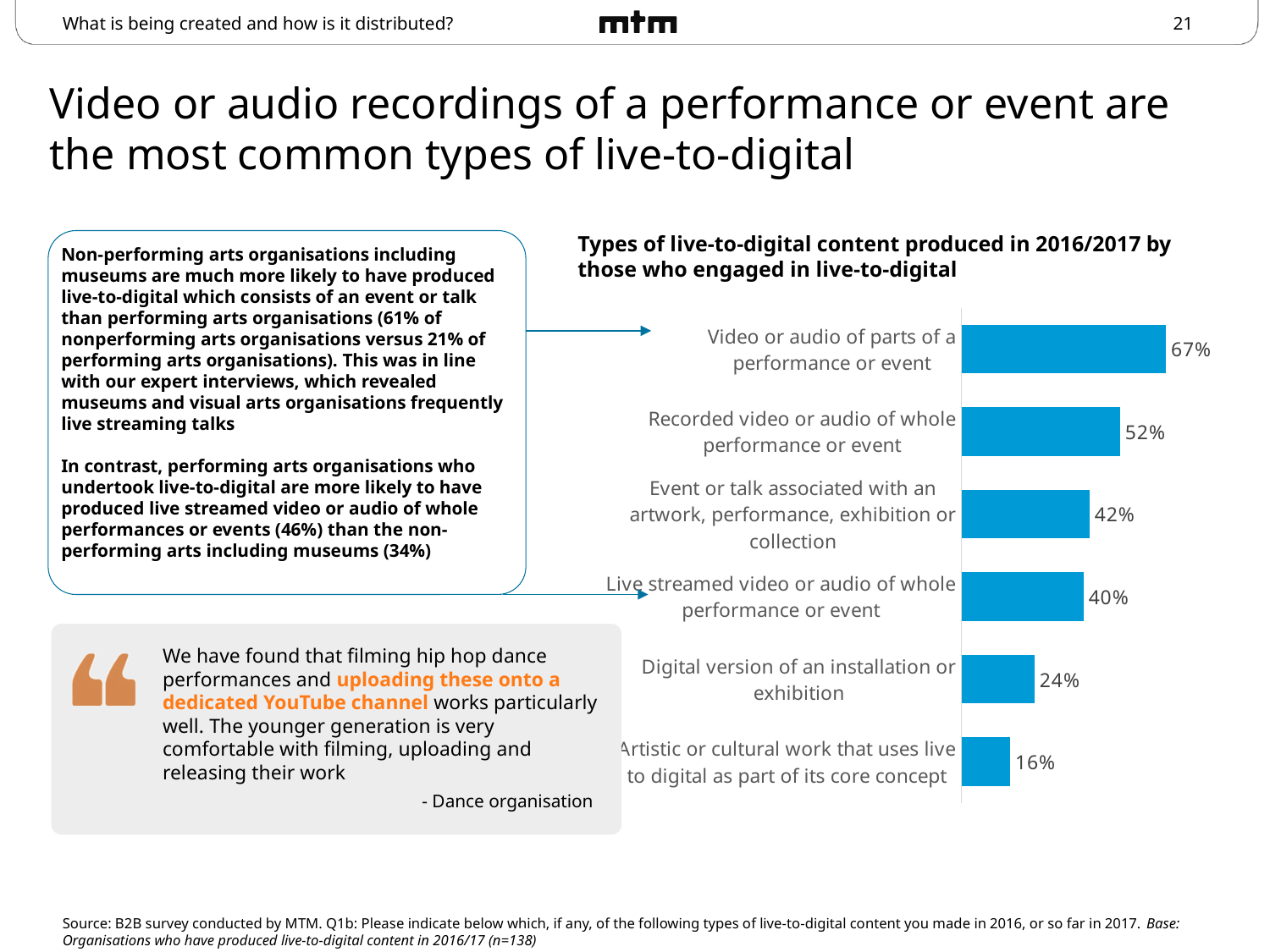
What kind of chart is used to show the types of live-to-digital content? Bar chart What is the difference between 'Event or talk associated with an artwork, performance, exhibition or collection' and 'Artistic or cultural work that uses live to digital as part of its core concept'? 26% What is the title of the chart? Types of live-to-digital content produced in 2016/2017 by those who engaged in live-to-digital What percentage of organisations produced video or audio of parts of a performance or event? 67% Which type of live-to-digital content has the highest percentage? Video or audio of parts of a performance or event How many types of live-to-digital content are shown in the chart? 6 What is the value for 'Live streamed video or audio of whole performance or event'? 40% Which type of live-to-digital content has the lowest percentage? Artistic or cultural work that uses live to digital as part of its core concept Which is larger: the value for 'Recorded video or audio of whole performance or event' or 'Live streamed video or audio of whole performance or event'? Recorded video or audio of whole performance or event What percentage produced a digital version of an installation or exhibition? 24% What is the difference between the percentage for 'Video or audio of parts of a performance or event' and 'Recorded video or audio of whole performance or event'? 15% What colour are the bars in the chart? Blue